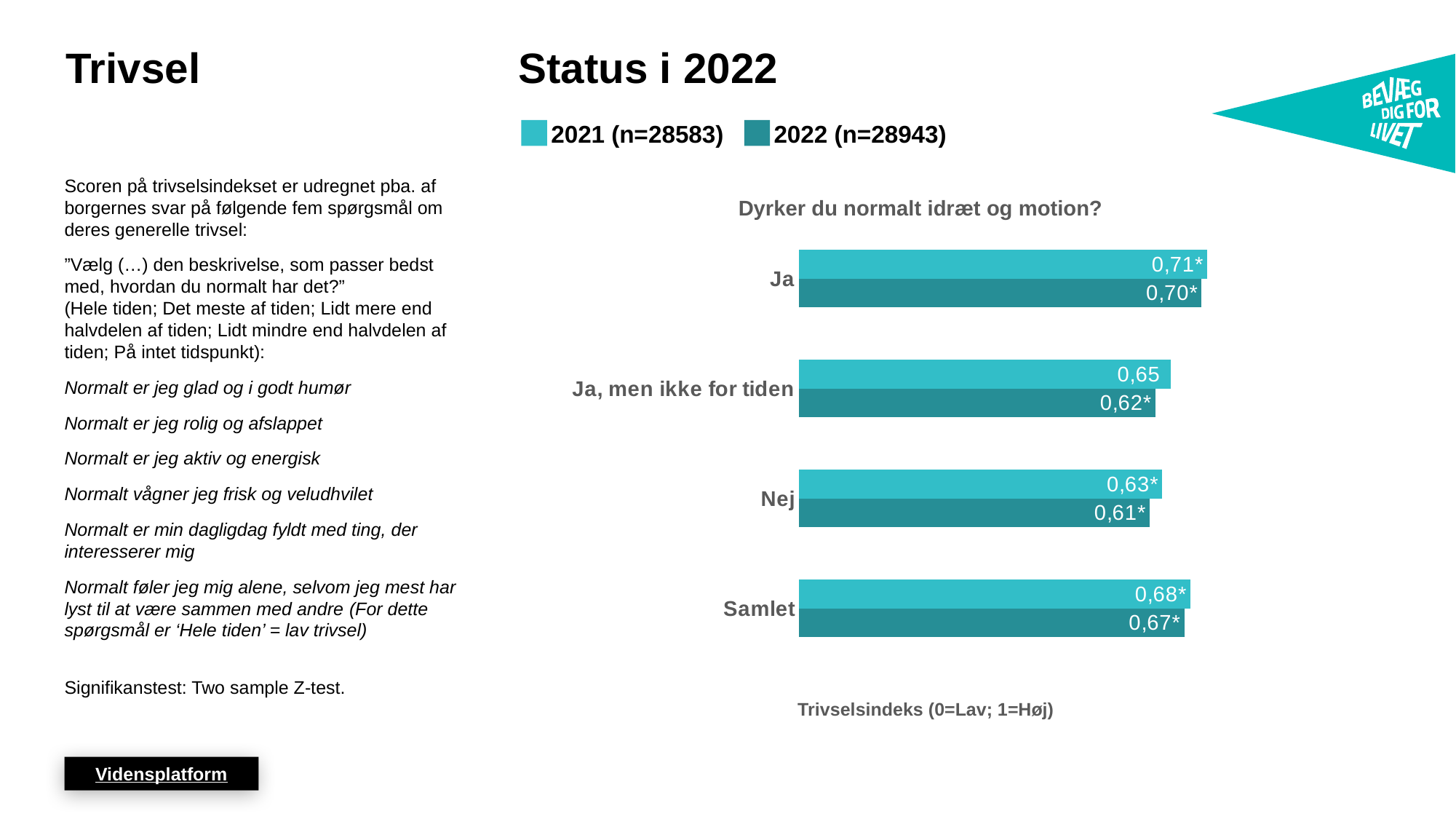
Which category has the lowest 2022 value? Nej What is the 2021 value for 'Ja, men ikke for tiden'? 0,65 What is the 2022 value for 'Samlet'? 0,67* How many series does the legend list? 2 What is the difference between the 2021 and 2022 values for 'Ja, men ikke for tiden'? 0,03 Which is larger: the 2021 value for 'Nej' or the 2021 value for 'Ja, men ikke for tiden'? Ja, men ikke for tiden Which category has the highest 2021 value? Ja What is the 2022 value for 'Nej'? 0,61* What is the title of the chart? Dyrker du normalt idræt og motion? How many categories are shown on the chart? 4 What type of chart is shown on the slide? Bar chart What is the 2021 value for 'Ja'? 0,71*